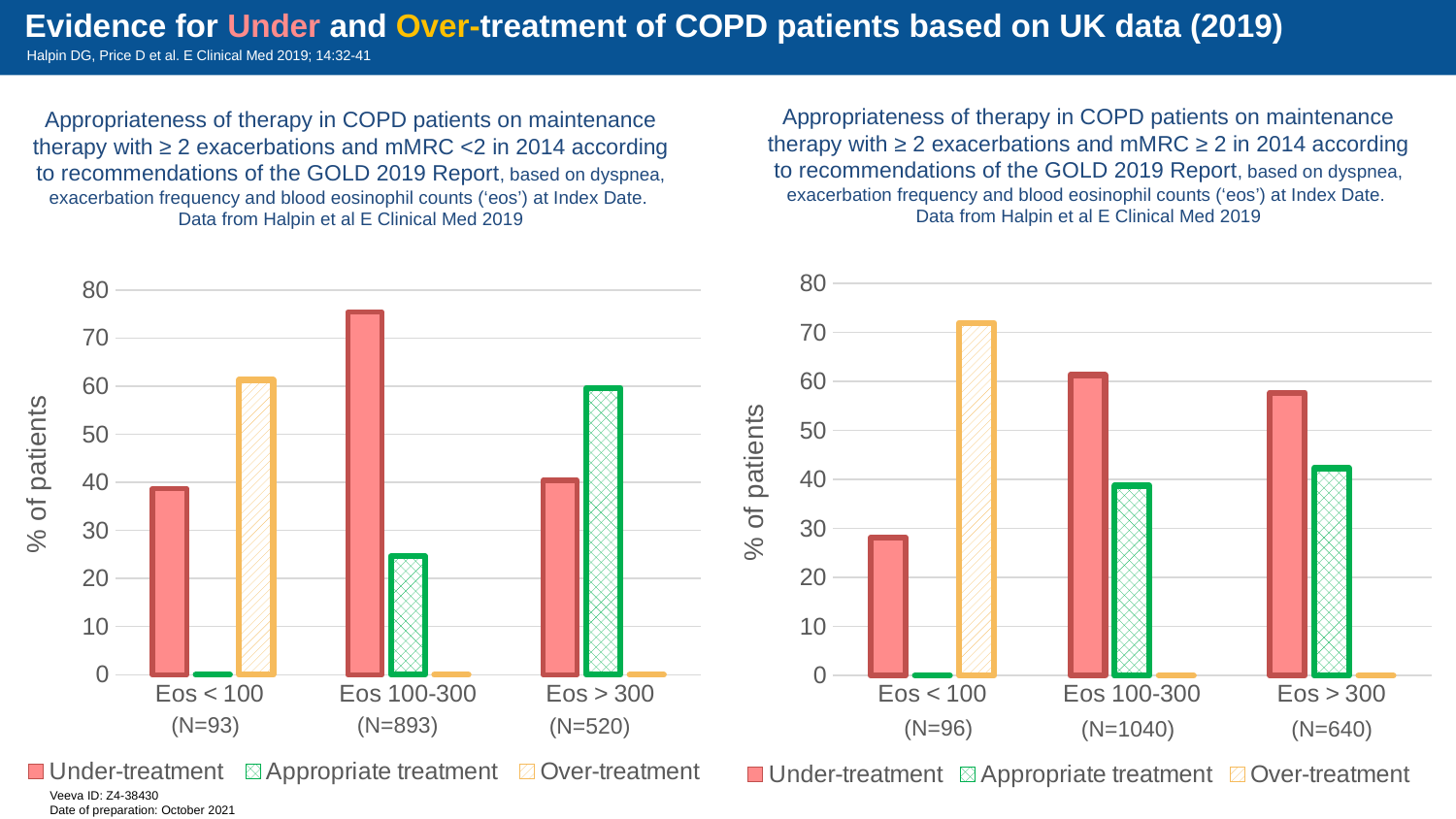
On the left chart, what kind of chart is shown? bar chart On the left chart, is the Under-treatment value for Eos 100-300 greater or less than 70? greater On the left chart, which eosinophil category has the highest Under-treatment bar? Eos 100-300 On the left chart, for Eos > 300, which is larger: Under-treatment or Appropriate treatment? Appropriate treatment On the right chart, is the Over-treatment value for Eos < 100 greater or less than 70? greater On the right chart, which eosinophil category has the lowest Under-treatment bar? Eos < 100 On the right chart, is the Appropriate treatment value for Eos > 300 greater or less than 50? less On the right chart, how many eosinophil categories are shown on the x axis? 3 On the left chart, how many series does the legend list? 3 On the right chart, what is the label of the y axis? % of patients On the right chart, for Eos 100-300, which is larger: Under-treatment or Appropriate treatment? Under-treatment